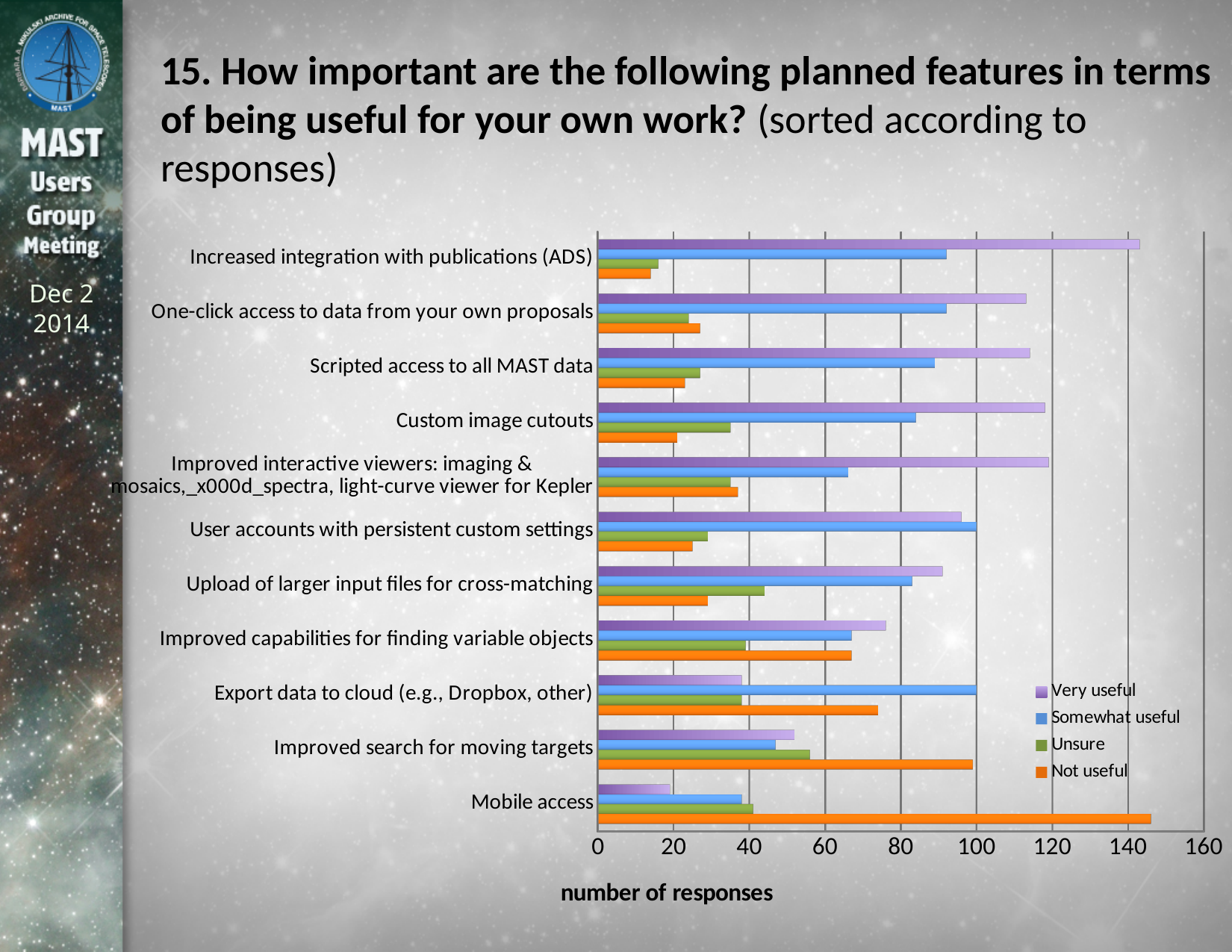
Is the 'Not useful' value for Mobile access greater or less than 140? greater Is the 'Somewhat useful' value for Export data to cloud (e.g., Dropbox, other) greater or less than 80? greater How many planned features (categories) are listed on the chart? 11 How many series does the legend list? 4 What is the title of the horizontal axis? number of responses Which feature has the highest 'Not useful' count? Mobile access Which feature has the lowest 'Not useful' count? Increased integration with publications (ADS) What kind of chart is shown on the slide? bar chart Is the 'Very useful' value for Increased integration with publications (ADS) greater or less than 140? greater Which has the larger 'Very useful' value: Custom image cutouts or Mobile access? Custom image cutouts Which feature has the lowest 'Very useful' count? Mobile access Which feature has the highest 'Very useful' count? Increased integration with publications (ADS)